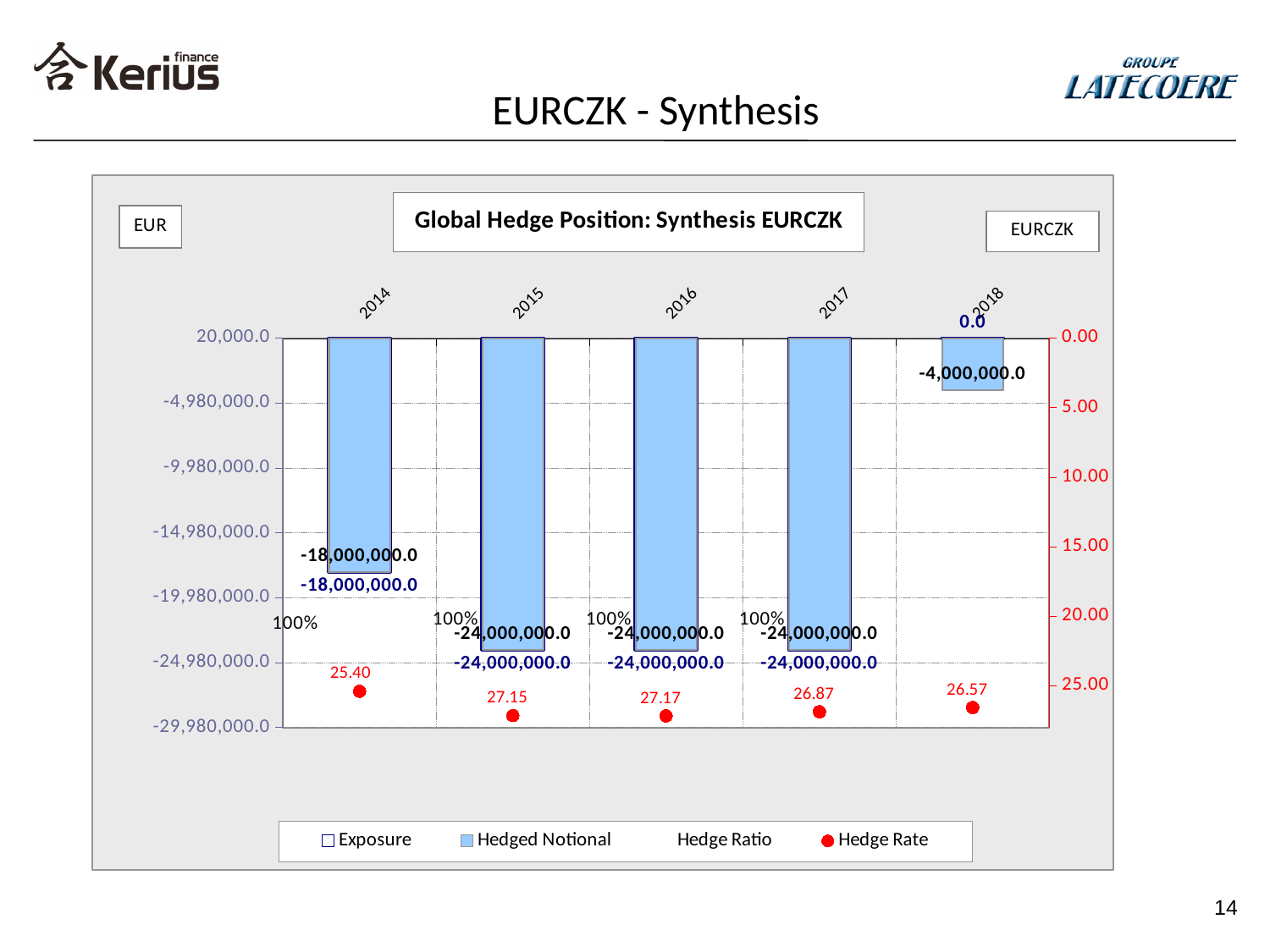
What is the Hedge Rate for 2016? 27.17 Which year has the lowest Hedge Rate? 2014 What is the Exposure value for 2018? 0.0 Which year has the higher Hedge Rate, 2017 or 2018? 2017 What is the difference between the Hedge Rate for 2015 and the Hedge Rate for 2014? 1.75 How many series does the legend list? 4 What is the Hedge Ratio shown for 2015? 100% How many years are shown on the x axis? 5 Which year has the highest Hedge Rate? 2016 What is the title of the chart? Global Hedge Position: Synthesis EURCZK What is the Hedge Rate for 2014? 25.40 What is the Hedged Notional value for 2018? -4,000,000.0